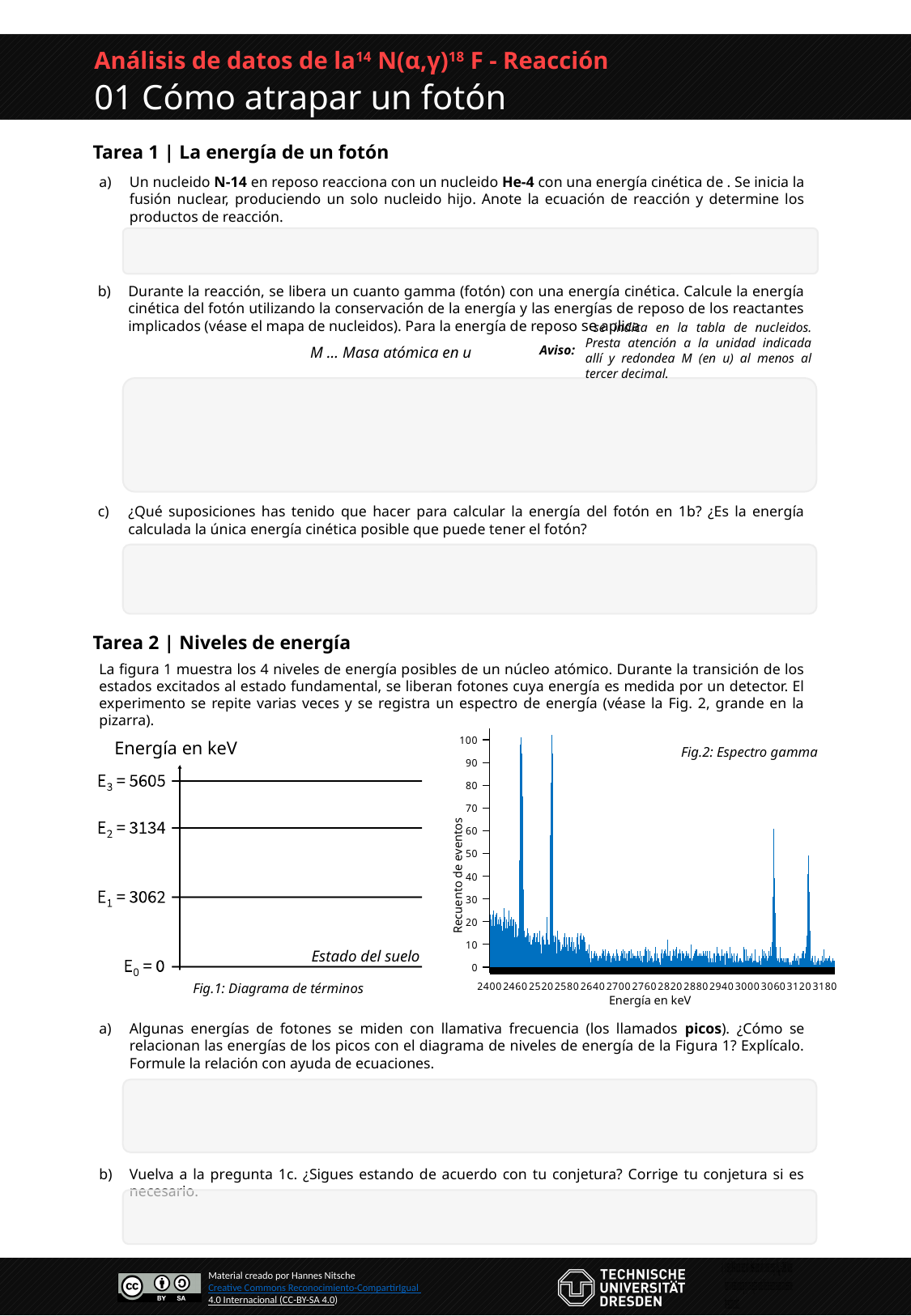
In Fig.1 (Diagrama de términos), what is the energy of level E1 in keV? 3062 In Fig.2 (Espectro gamma), what is the highest value shown on the y axis? 100 In Fig.2 (Espectro gamma), is the peak near 3060 keV taller or shorter than the peak near 3120 keV? taller In Fig.1 (Diagrama de términos), what is the energy of level E3 in keV? 5605 In Fig.1 (Diagrama de términos), how many energy levels are shown? 4 In Fig.2 (Espectro gamma), what is the title of the y axis? Recuento de eventos In Fig.1 (Diagrama de términos), what is the difference in keV between E2 and E1? 72 In Fig.2 (Espectro gamma), is the count at the tallest peak (near 2460 keV) greater or less than 90? greater In Fig.2 (Espectro gamma), is the count at the peak near 3060 keV greater or less than 40? greater In Fig.2 (Espectro gamma), is the count at the peak near 3120 keV greater or less than 60? less In Fig.2 (Espectro gamma), what is the title of the x axis? Energía en keV